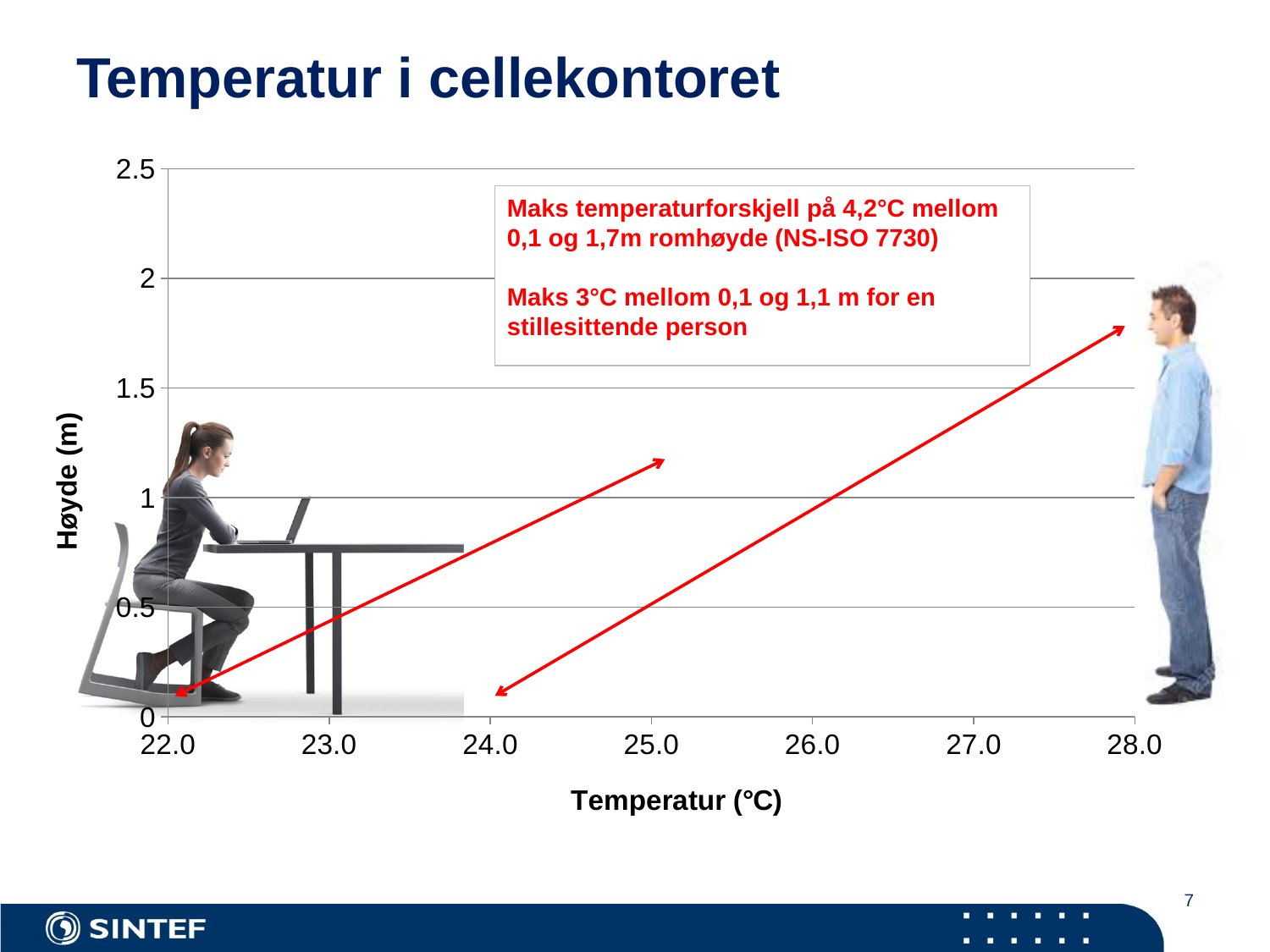
How many red arrows are drawn on the chart? 2 What is the title of the y axis of the chart? Høyde (m) Is the temperature at the lower end of the shorter (left-hand) red arrow greater or less than 23.0? less What is the title of the x axis of the chart? Temperatur (°C) How many labelled tick values are shown on the x axis (Temperatur)? 7 Do the red arrows rise or fall as temperature increases along the x axis? rise Is the height at the upper end of the shorter (left-hand) red arrow greater or less than 1.5? less Which red arrow reaches the greater height, the left-hand one or the right-hand one? the right-hand one Is the temperature at the upper end of the longer (right-hand) red arrow greater or less than 27.0? greater